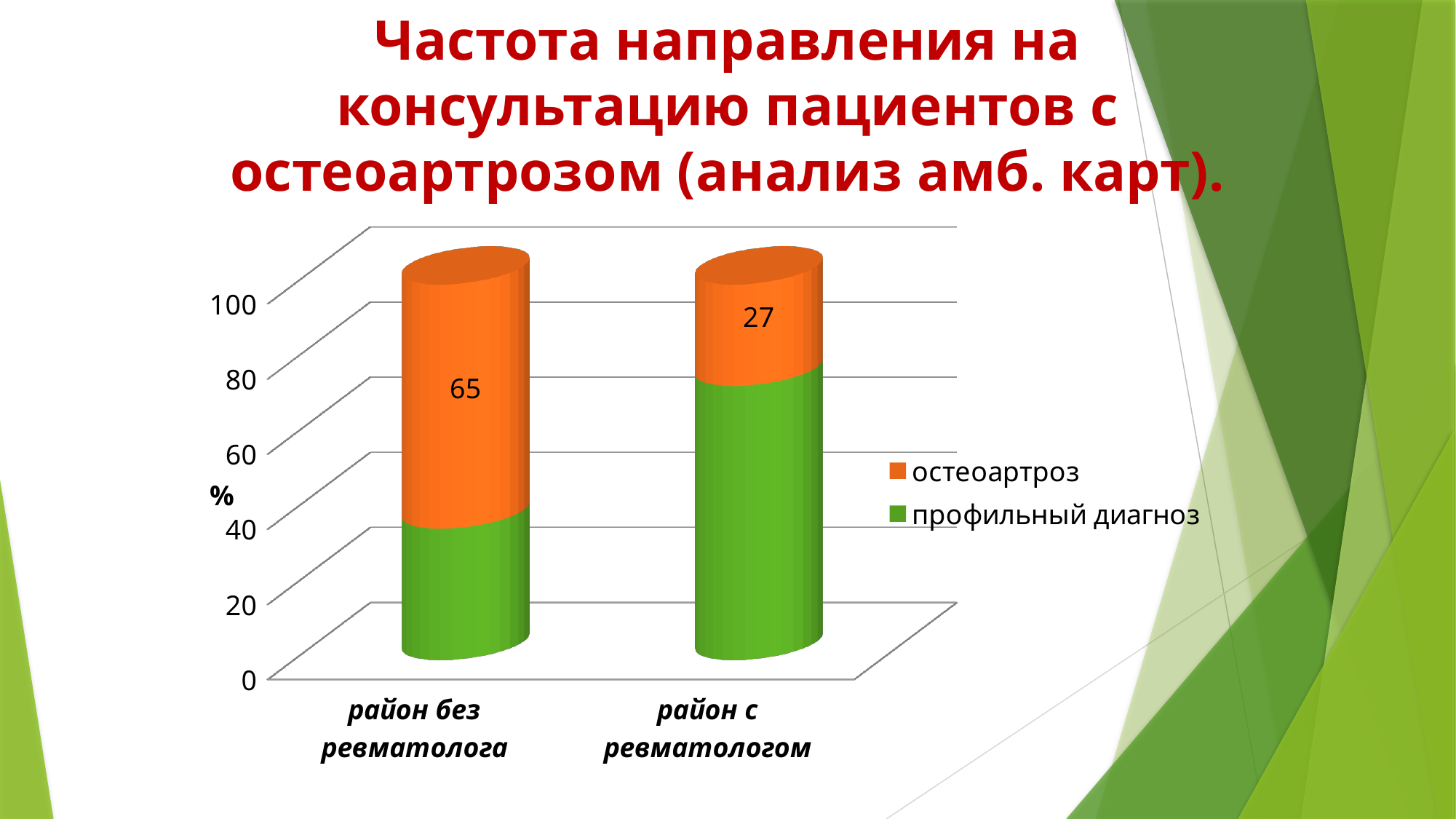
How many series does the legend list? 2 Which category has the higher value for остеоартроз? район без ревматолога Which colour represents остеоартроз in the chart? orange What is the value of остеоартроз for район с ревматологом? 27 Is the остеоартроз value for район с ревматологом greater or less than 40? less Is the остеоартроз value for район без ревматолога larger or smaller than that for район с ревматологом? larger What is the label on the vertical axis? % What kind of chart is shown on the slide? stacked bar chart Which category has the lower value for остеоартроз? район с ревматологом How many categories are shown on the x axis? 2 What is the value of остеоартроз for район без ревматолога? 65 What is the difference between the остеоартроз values for район без ревматолога and район с ревматологом? 38